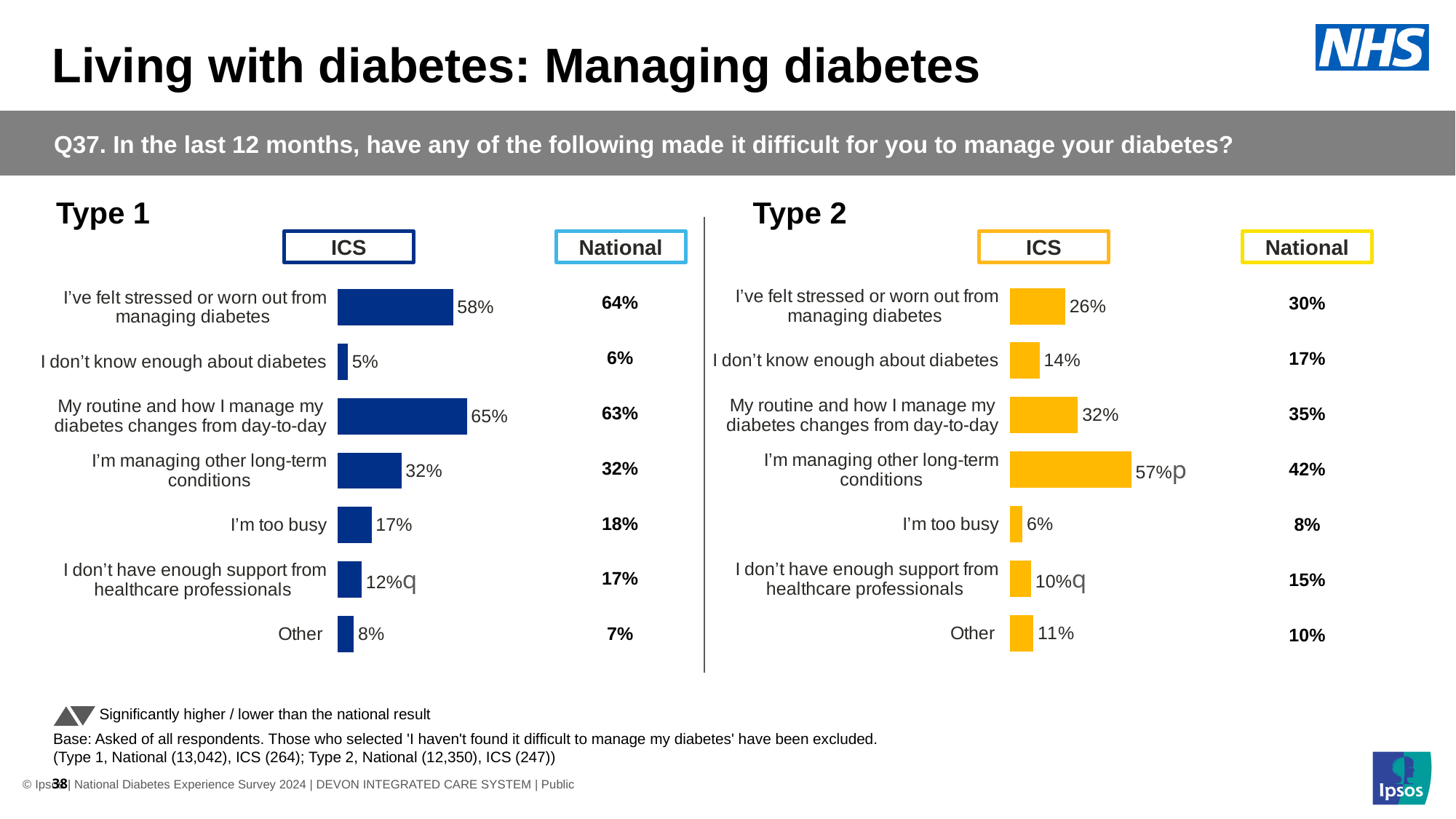
In the Type 2 chart, what is the difference between the ICS value and the National value for 'I'm managing other long-term conditions'? 15% How many categories are shown in the Type 1 chart? 7 In the Type 1 chart, which category has the highest ICS value? My routine and how I manage my diabetes changes from day-to-day In the Type 2 chart, which category has the lowest ICS value? I'm too busy In the Type 1 chart, what is the difference between the ICS value and the National value for 'I've felt stressed or worn out from managing diabetes'? 6% In the Type 1 chart, what is the National value for 'I don't have enough support from healthcare professionals'? 17% What colour are the ICS bars in the Type 2 chart? Yellow In the Type 2 chart, what is the ICS value for 'I'm managing other long-term conditions'? 57% What kind of chart is used for the ICS values in the Type 2 chart? Bar chart In the Type 1 chart, which is larger: the ICS value for 'I'm too busy' or the ICS value for 'Other'? I'm too busy In the Type 1 chart, what is the ICS value for 'I've felt stressed or worn out from managing diabetes'? 58% In the Type 2 chart, which is larger for 'I don't know enough about diabetes': the ICS value or the National value? National